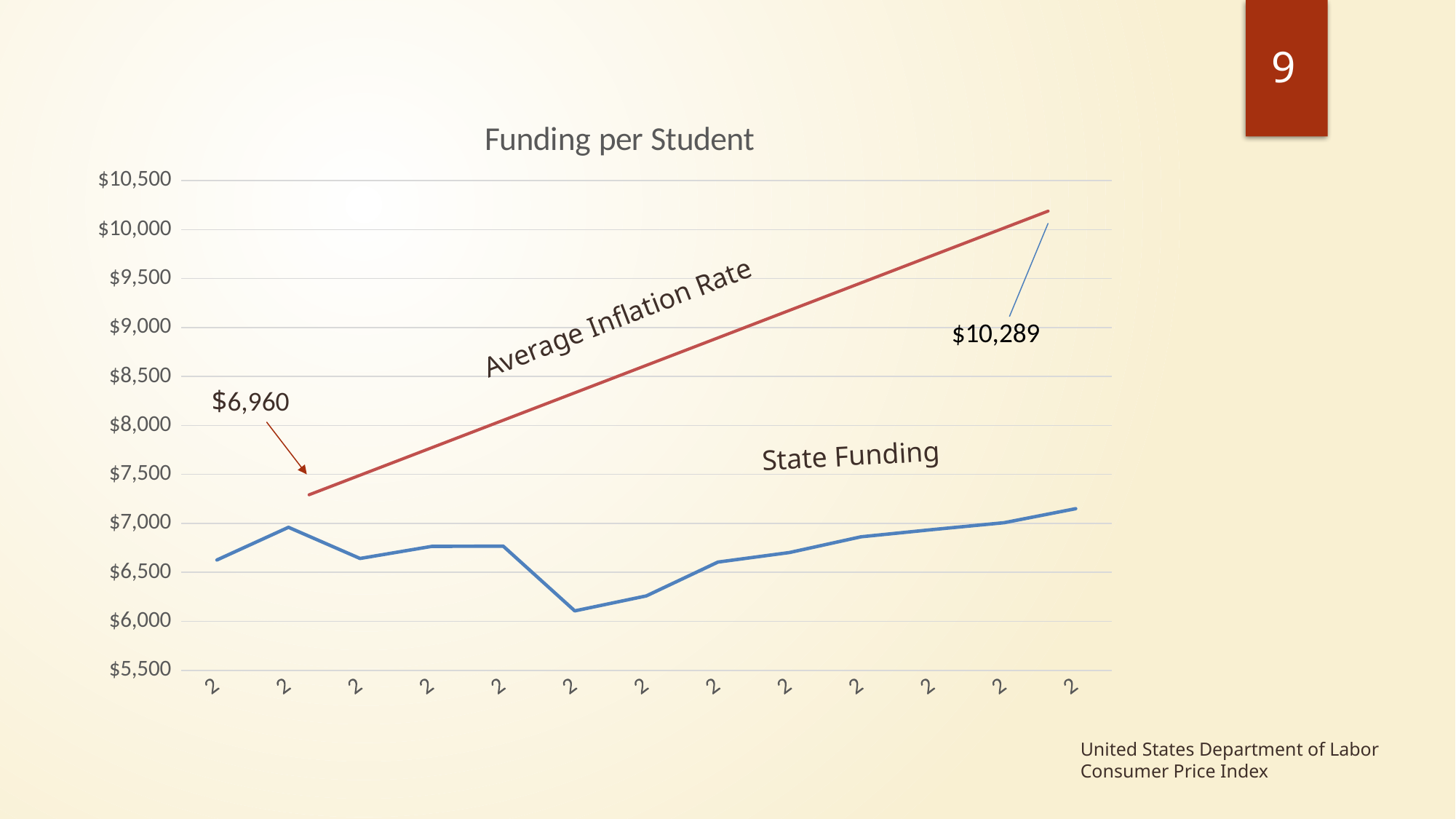
Is the value of the State Funding line at its right end greater or less than $7,000? greater How many tick marks are there along the x axis? 13 At the right end of the chart, which line is higher: Average Inflation Rate or State Funding? Average Inflation Rate Is the lowest value of the State Funding line greater or less than $6,500? less Does the Average Inflation Rate line rise or fall from left to right? rise What are the names of the two lines plotted on the chart? Average Inflation Rate and State Funding Is the value of the Average Inflation Rate line at its right end greater or less than $10,000? greater What is the title of the chart? Funding per Student What kind of chart is shown on the slide? line chart How many lines are plotted on the chart? 2